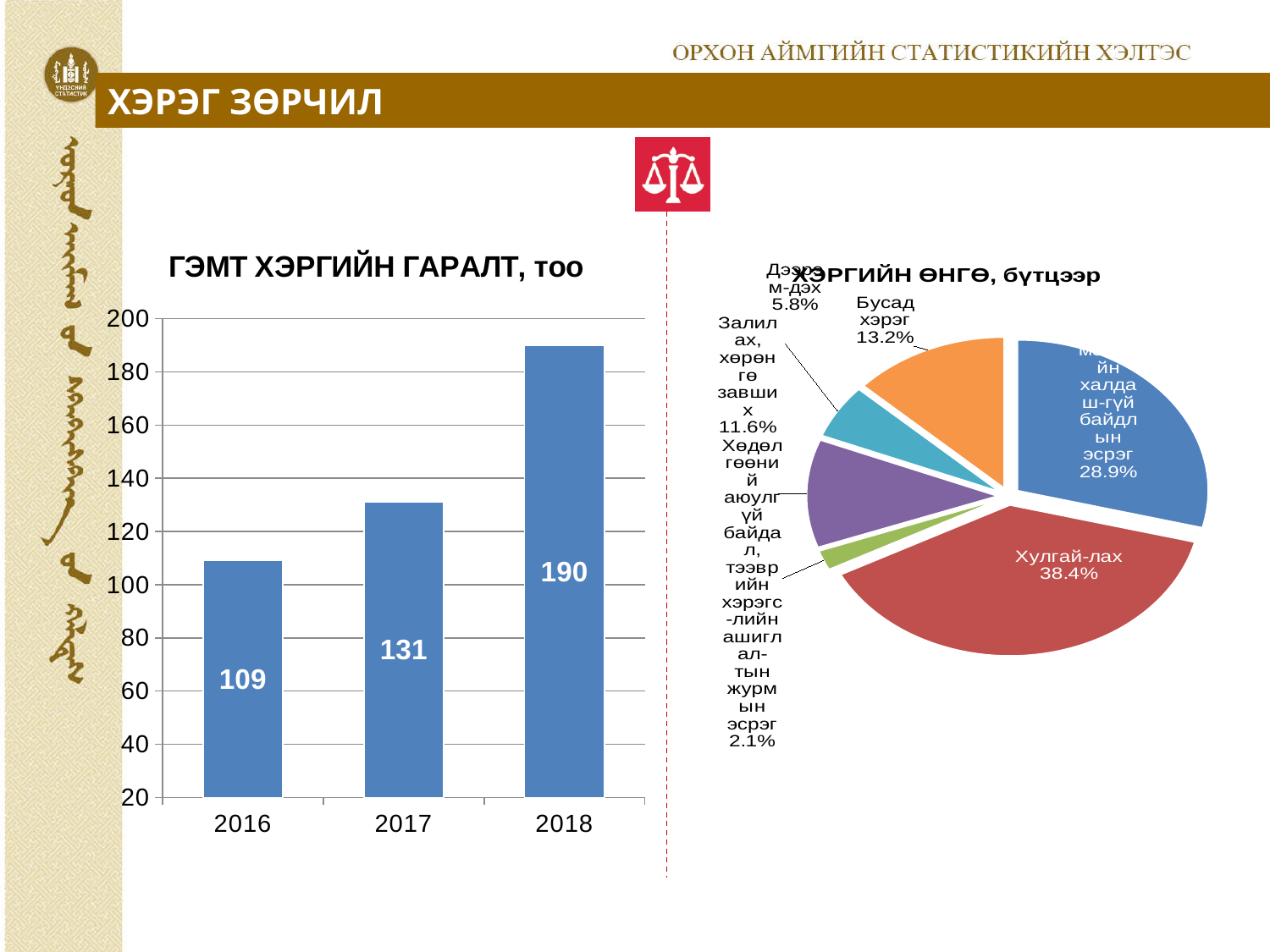
In the bar chart 'ГЭМТ ХЭРГИЙН ГАРАЛТ, тоо', how many years are shown? 3 What kind of chart is 'ГЭМТ ХЭРГИЙН ГАРАЛТ, тоо'? bar chart In the pie chart 'ХЭРГИЙН ӨНГӨ, бүтцээр', what share does 'Хулгайлах' have? 38.4% In the pie chart 'ХЭРГИЙН ӨНГӨ, бүтцээр', which slice is the largest? Хулгайлах In the bar chart 'ГЭМТ ХЭРГИЙН ГАРАЛТ, тоо', what is the value for 2016? 109 In the bar chart 'ГЭМТ ХЭРГИЙН ГАРАЛТ, тоо', which year has the lowest value? 2016 In the pie chart 'ХЭРГИЙН ӨНГӨ, бүтцээр', what share does 'Бусад хэрэг' have? 13.2% In the bar chart 'ГЭМТ ХЭРГИЙН ГАРАЛТ, тоо', which year has the highest value? 2018 In the bar chart 'ГЭМТ ХЭРГИЙН ГАРАЛТ, тоо', what is the value for 2018? 190 In the bar chart 'ГЭМТ ХЭРГИЙН ГАРАЛТ, тоо', what is the difference between the 2018 and 2017 values? 59 In the pie chart 'ХЭРГИЙН ӨНГӨ, бүтцээр', which is larger: 'Залилах, хөрөнгө завших' or 'Дээрэмдэх'? Залилах, хөрөнгө завших In the bar chart 'ГЭМТ ХЭРГИЙН ГАРАЛТ, тоо', do the values rise or fall from 2016 to 2018? rise